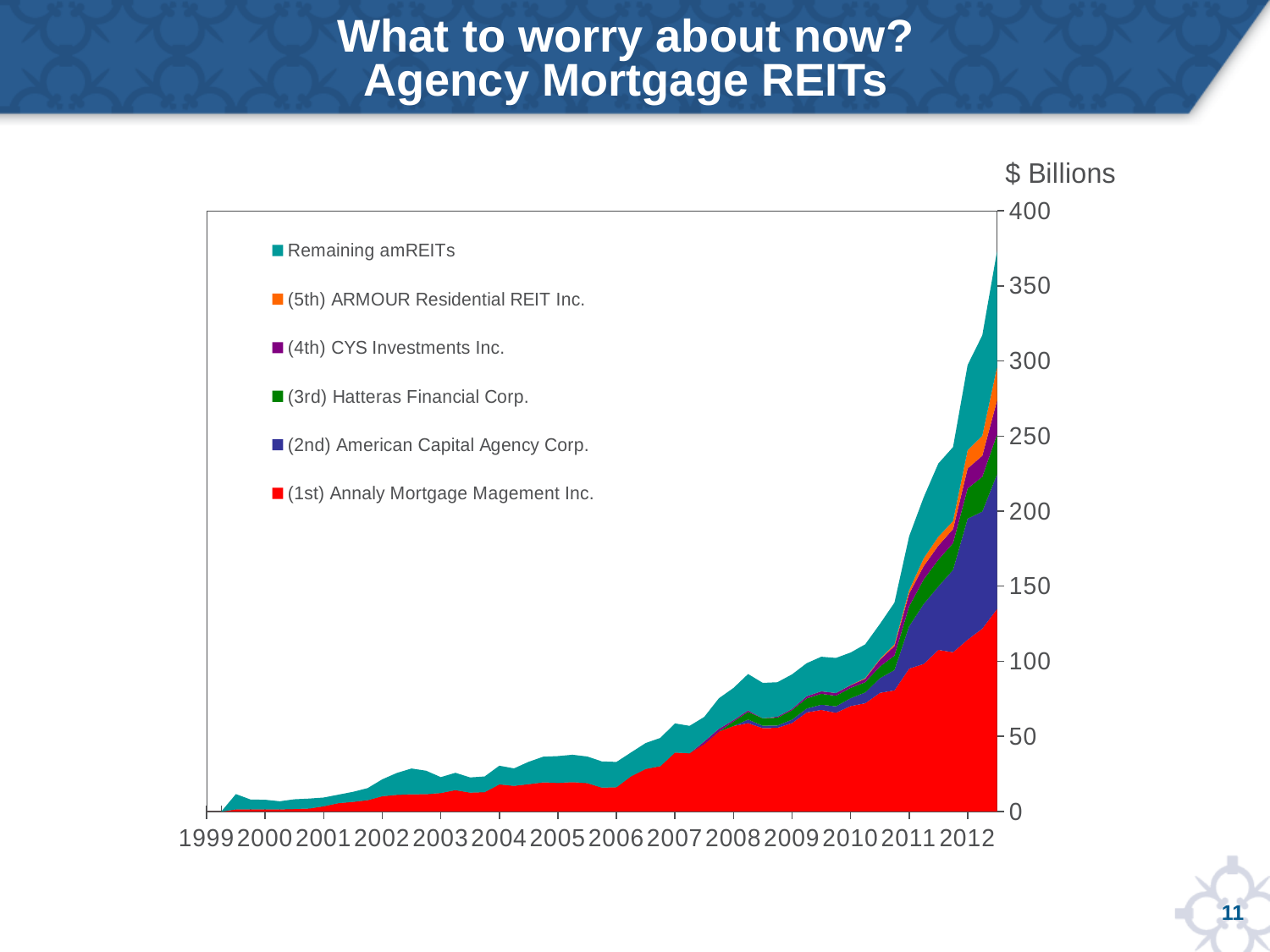
Is the total value in 2005 greater or less than 50? less What unit is shown above the y axis? $ Billions Do the total values rise or fall from 1999 to 2012? Rise What kind of chart is shown on the slide? Stacked area chart Is the value for (1st) Annaly Mortgage Magement Inc. at the end of 2012 greater or less than 100? greater Which series has the largest value at the end of 2012? (1st) Annaly Mortgage Magement Inc. How many years are labelled on the x axis? 14 Is the total value at the end of 2012 greater or less than 350? greater At the end of 2012, which is larger: (1st) Annaly Mortgage Magement Inc. or (2nd) American Capital Agency Corp.? (1st) Annaly Mortgage Magement Inc. Which series is shown in red? (1st) Annaly Mortgage Magement Inc. How many series does the legend list? 6